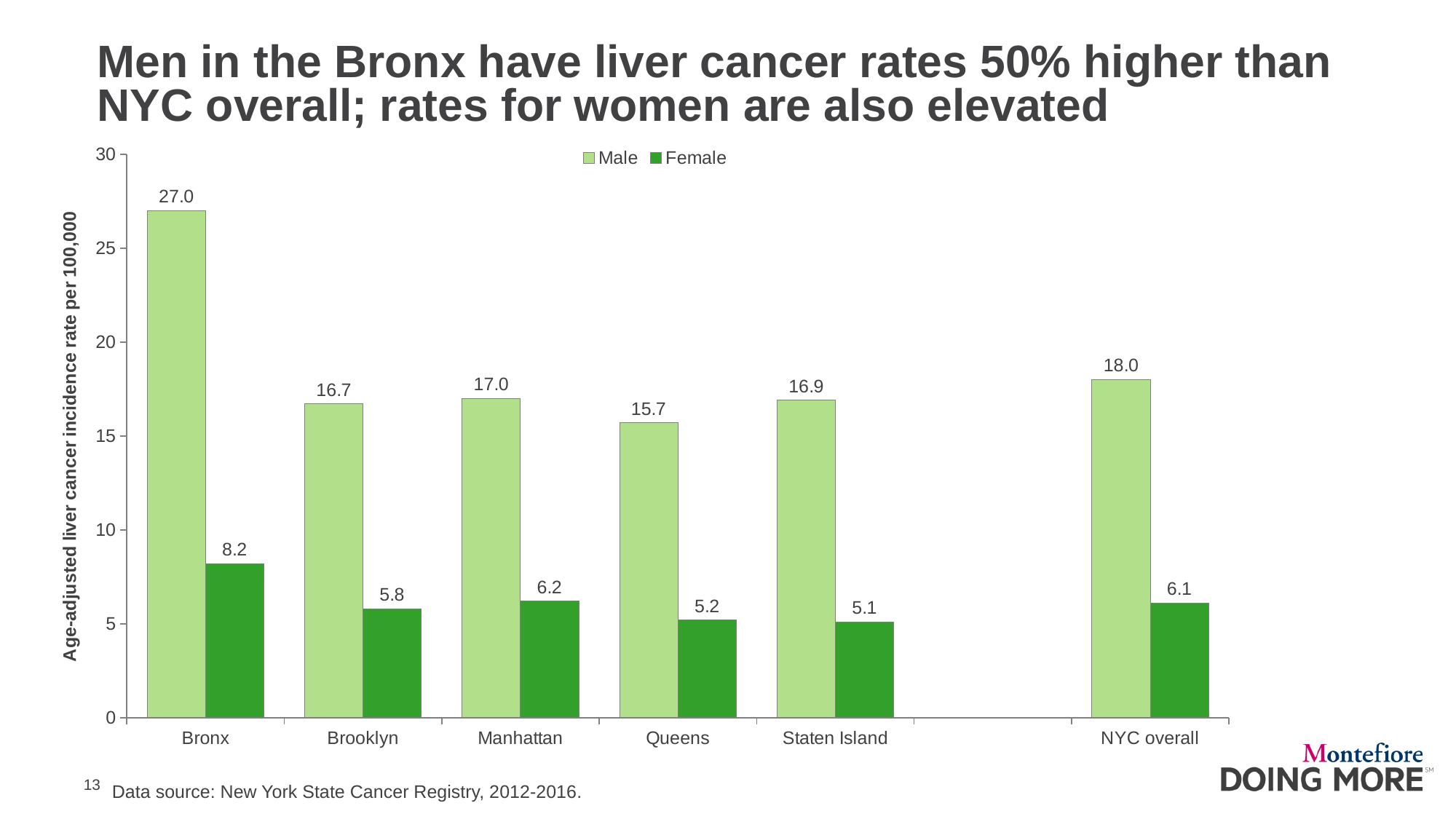
Which category has the lowest female liver cancer incidence rate? Staten Island What is the difference between the male and female rates for Brooklyn? 10.9 What is the male liver cancer incidence rate for NYC overall? 18.0 What kind of chart is shown on the slide? bar chart How many categories are shown on the x axis? 6 Is the male rate for Queens greater or less than 20? less What is the difference between the male rates for the Bronx and NYC overall? 9.0 What is the female liver cancer incidence rate for Queens? 5.2 What is the male liver cancer incidence rate for the Bronx? 27.0 How many series does the legend list? 2 Which category has the highest male liver cancer incidence rate? Bronx Which is larger, the female rate for Manhattan or the female rate for Brooklyn? Manhattan